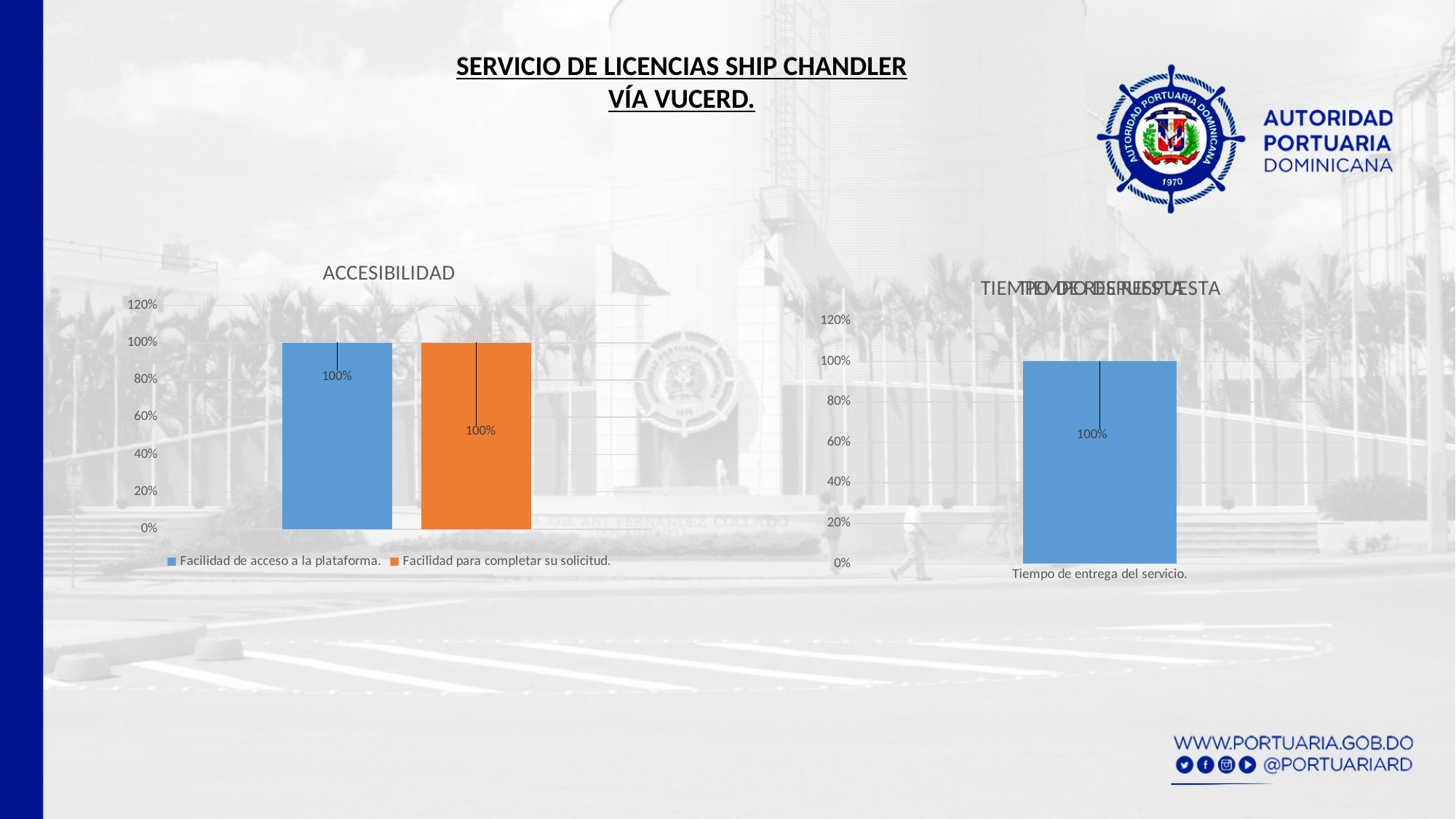
What is the title of the chart on the left of the slide? ACCESIBILIDAD In the chart on the right of the slide, what is the value for Tiempo de entrega del servicio? 100% In the ACCESIBILIDAD chart, which colour is used for the Facilidad para completar su solicitud series? Orange How many series does the legend of the ACCESIBILIDAD chart list? 2 What kind of chart is the ACCESIBILIDAD chart? Bar chart In the ACCESIBILIDAD chart, what is the difference between the values for Facilidad de acceso a la plataforma and Facilidad para completar su solicitud? 0% How many bars are plotted in the chart on the right of the slide? 1 In the ACCESIBILIDAD chart, what is the value for Facilidad para completar su solicitud? 100% In the ACCESIBILIDAD chart, is the value for Facilidad para completar su solicitud greater or less than 80%? greater What kind of chart is the chart on the right of the slide? Bar chart In the chart on the right of the slide, is the value for Tiempo de entrega del servicio greater or less than 60%? greater In the ACCESIBILIDAD chart, what is the value for Facilidad de acceso a la plataforma? 100%